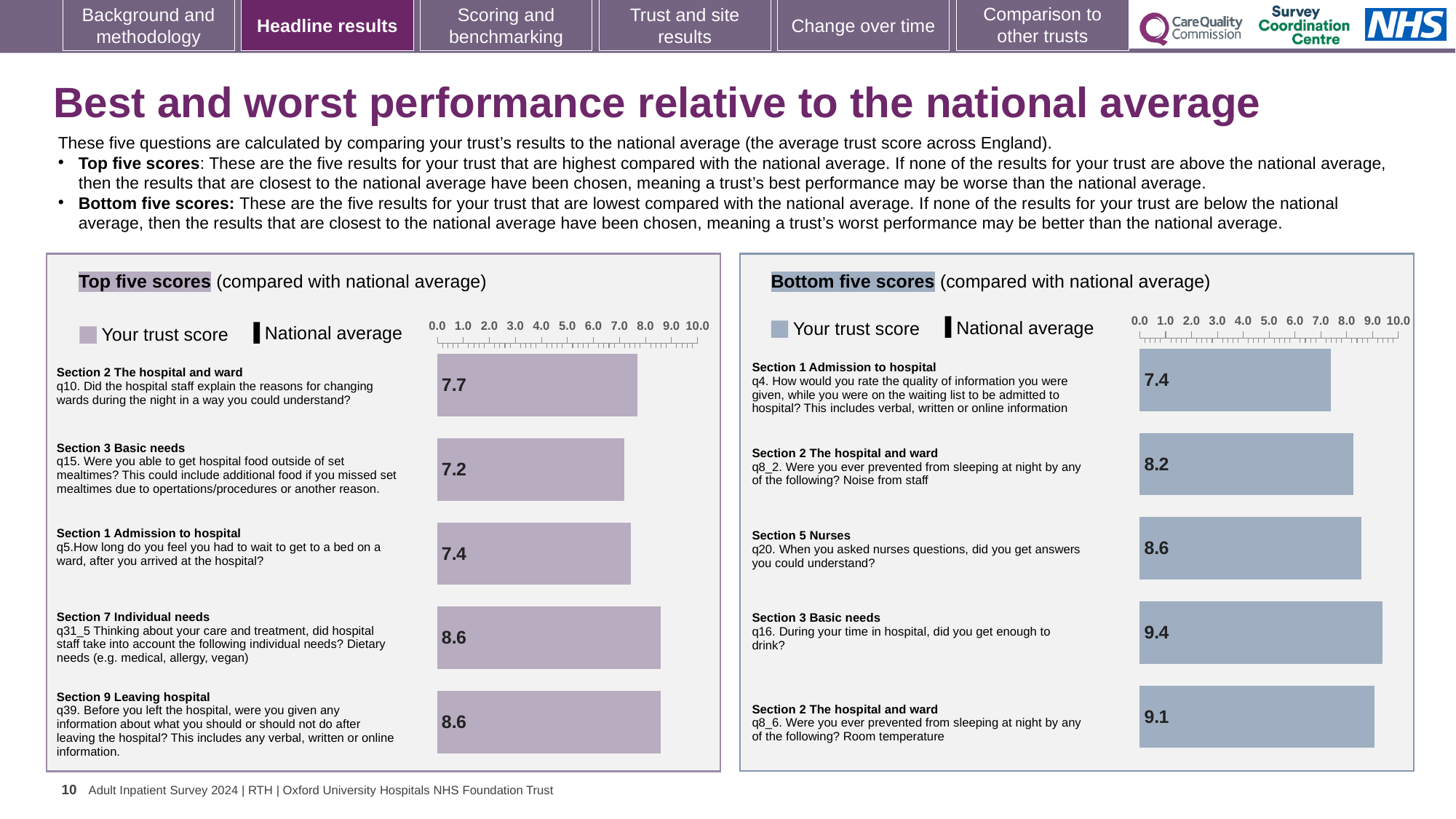
In the Top five scores chart, which question has the lowest trust score? q15 (hospital food outside of set mealtimes) In the Bottom five scores chart, what is the difference between the trust scores for q20 (nurses' answers you could understand) and q4 (information while on the waiting list)? 1.2 In the Top five scores chart, what is the difference between the trust score for q31_5 (dietary needs) and q5 (wait to get to a bed on a ward)? 1.2 In the Top five scores chart, what is the trust score for q15 about getting hospital food outside of set mealtimes? 7.2 In the Bottom five scores chart, which question has the highest trust score? q16 (did you get enough to drink?) In the Top five scores chart, how many questions are plotted? 5 What kind of chart is used in the Top five scores panel? Bar chart In the Top five scores chart, what is the trust score for q10 (Did the hospital staff explain the reasons for changing wards during the night in a way you could understand?)? 7.7 In the Bottom five scores chart, what is the trust score for q16 (During your time in hospital, did you get enough to drink?)? 9.4 In the Bottom five scores chart, which question has the lowest trust score? q4 (quality of information while on the waiting list) In the Bottom five scores chart, which has the larger trust score: q8_2 (Noise from staff) or q8_6 (Room temperature)? q8_6 (Room temperature) How many series does the legend of the Bottom five scores chart list? 2